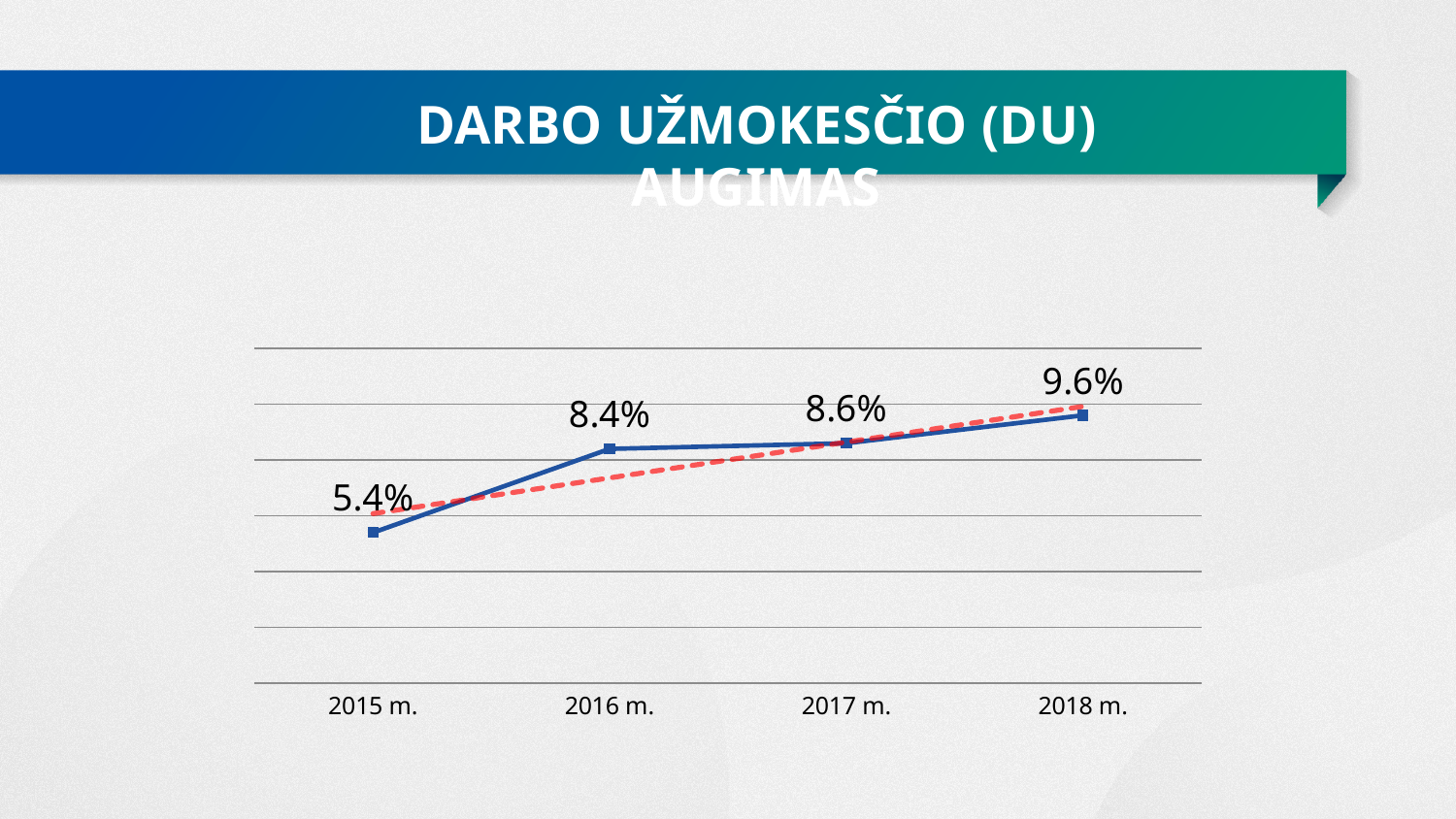
Do the values rise or fall from 2015 m. to 2018 m.? rise Which year has the highest value? 2018 m. What is the difference between the values for 2018 m. and 2015 m.? 4.2% What is the difference between the values for 2016 m. and 2015 m.? 3.0% What is the value for 2018 m.? 9.6% What kind of chart is shown on the slide? line chart What is the value for 2015 m.? 5.4% What is the value for 2016 m.? 8.4% Which is larger, the value for 2016 m. or the value for 2018 m.? 2018 m. What is the value for 2017 m.? 8.6% Which year has the lowest value? 2015 m. How many years are shown on the x axis? 4